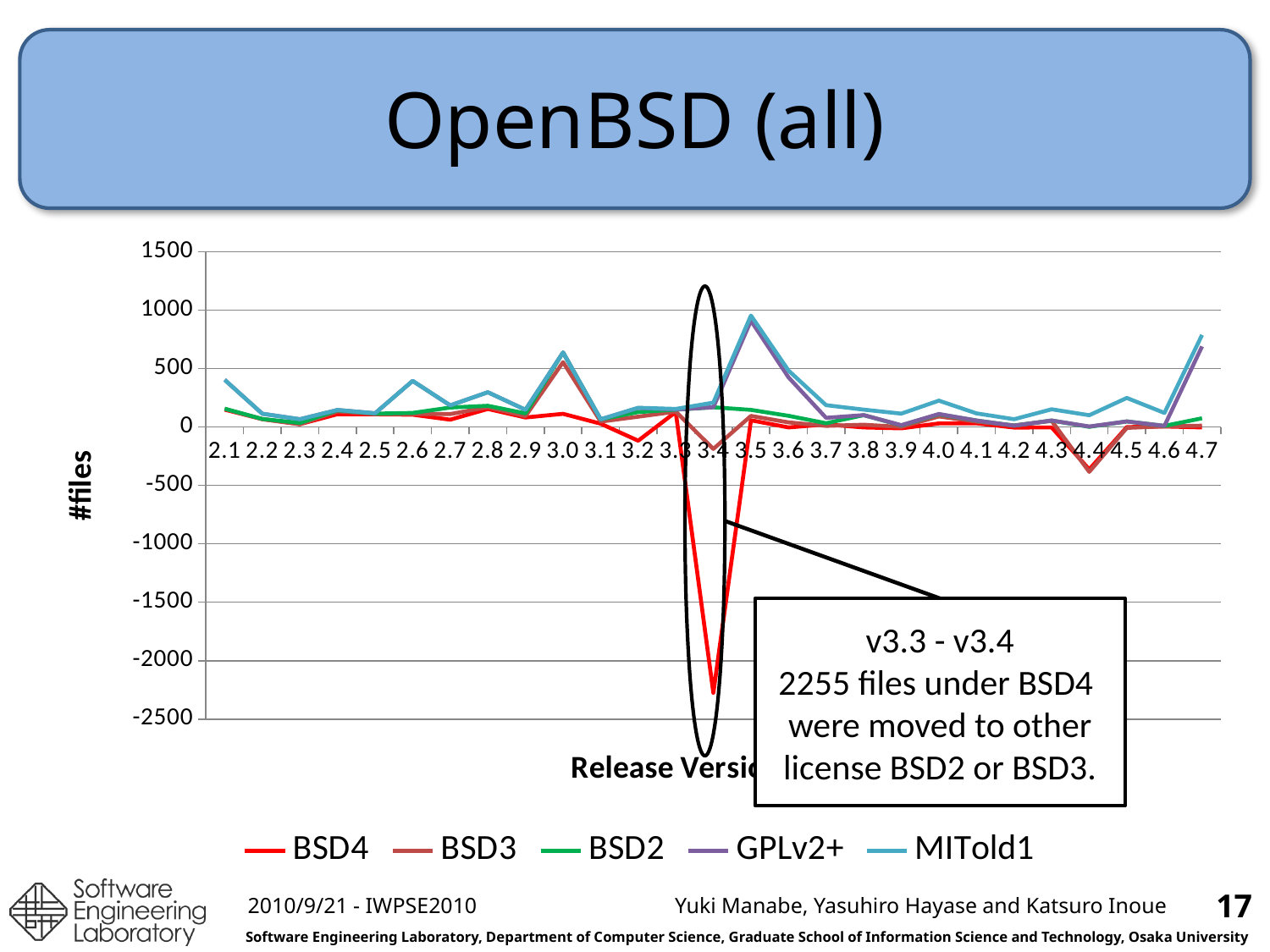
Which series has the lowest value at release version 3.4? BSD4 How many series does the legend list? 5 Is the value for BSD3 at release version 4.4 greater or less than 0? less Is the value for BSD4 at release version 3.4 greater or less than -2000? less Which is larger: the value for BSD4 at version 3.4 or the value for BSD3 at version 4.4? BSD3 at version 4.4 What is the label of the y axis? #files What kind of chart is shown on the slide? line chart According to the annotation, how many files under BSD4 were moved to other licenses between v3.3 and v3.4? 2255 How many release versions are shown along the x axis? 27